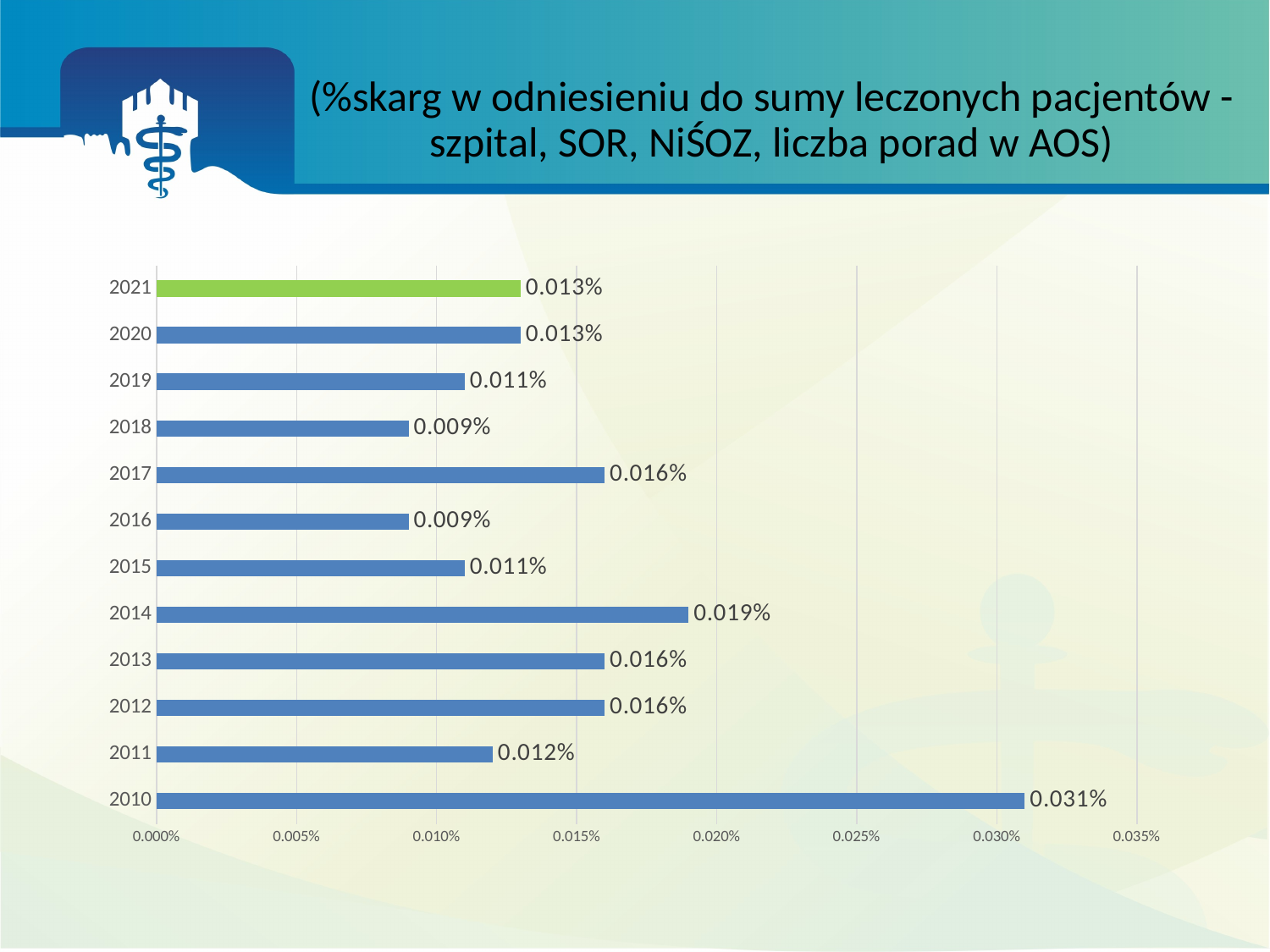
What is the value for 2014? 0.019% Which is larger, the value for 2014 or the value for 2017? 2014 What colour is the bar for 2021? green What kind of chart is shown on the slide? bar chart What is the value for 2010? 0.031% Which year has the highest value? 2010 What is the value for 2011? 0.012% Is the value for 2014 greater or less than 0.015%? greater What is the difference between the values for 2010 and 2014? 0.012% What is the difference between the values for 2017 and 2018? 0.007% What is the value for 2021? 0.013% How many years are shown on the chart? 12